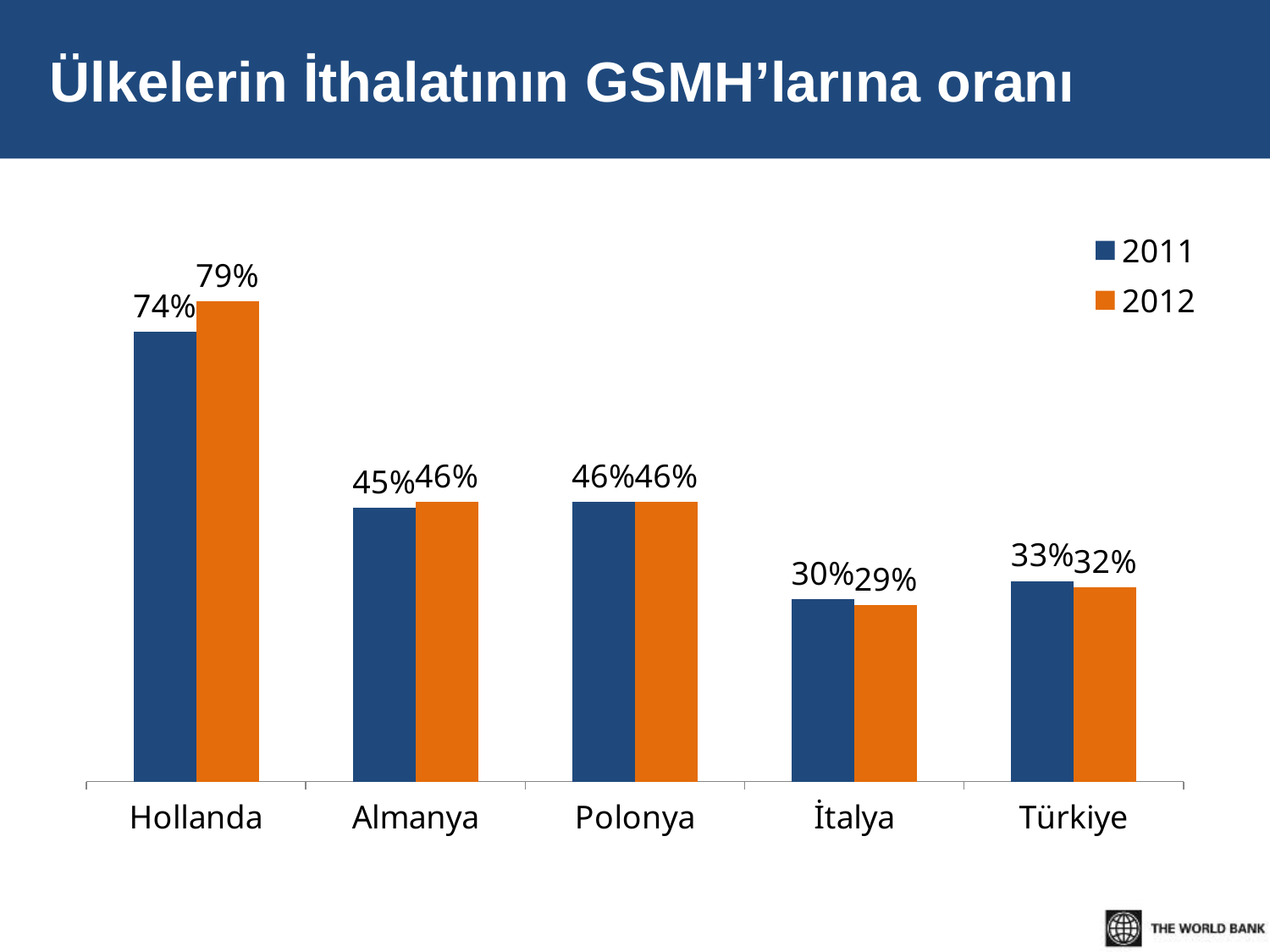
Which country has the highest 2012 value? Hollanda Which is larger for Türkiye, the 2011 value or the 2012 value? 2011 Which country has the lowest 2011 value? İtalya What is the difference between the 2012 and 2011 values for Hollanda? 5% What is the title of the slide? Ülkelerin İthalatının GSMH'larına oranı Which colour represents the 2012 series? Orange What kind of chart is shown on the slide? Bar chart What is the 2012 value for Türkiye? 32% What is the 2011 value for Hollanda? 74% How many series does the legend list? 2 How many countries are shown on the x axis? 5 What is the 2012 value for İtalya? 29%